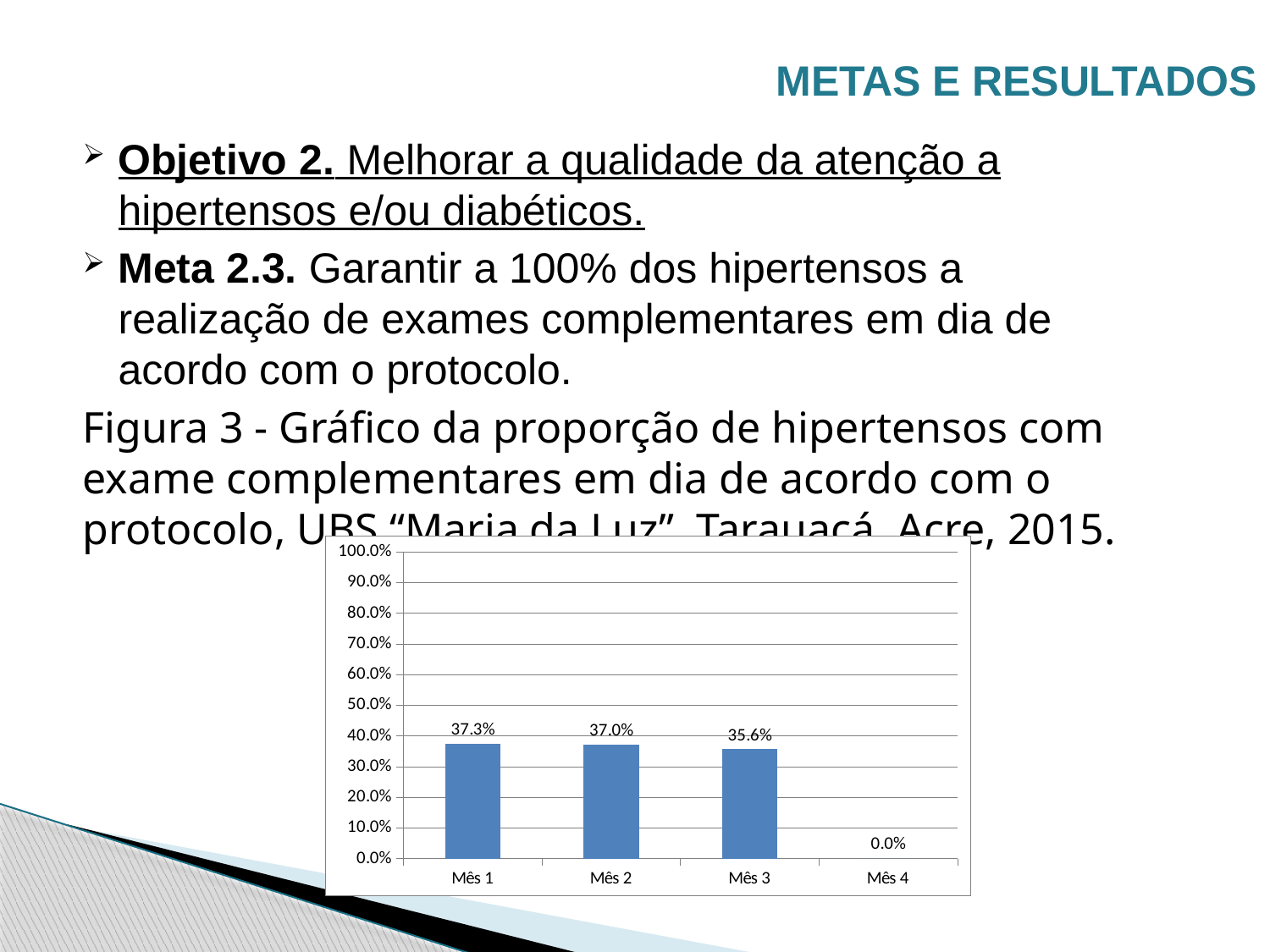
How many months are shown on the x axis? 4 What is the value for Mês 1? 37.3% Is the value for Mês 2 greater or less than 50.0%? less What kind of chart is shown on the slide? bar chart What is the difference between the values for Mês 2 and Mês 3? 1.4% Which month has the highest value? Mês 1 Which is larger, the value for Mês 2 or the value for Mês 4? Mês 2 What is the value for Mês 4? 0.0% Which month has the lowest value? Mês 4 What is the value for Mês 3? 35.6% What is the difference between the values for Mês 1 and Mês 3? 1.7% Do the values rise or fall from Mês 1 to Mês 4? fall